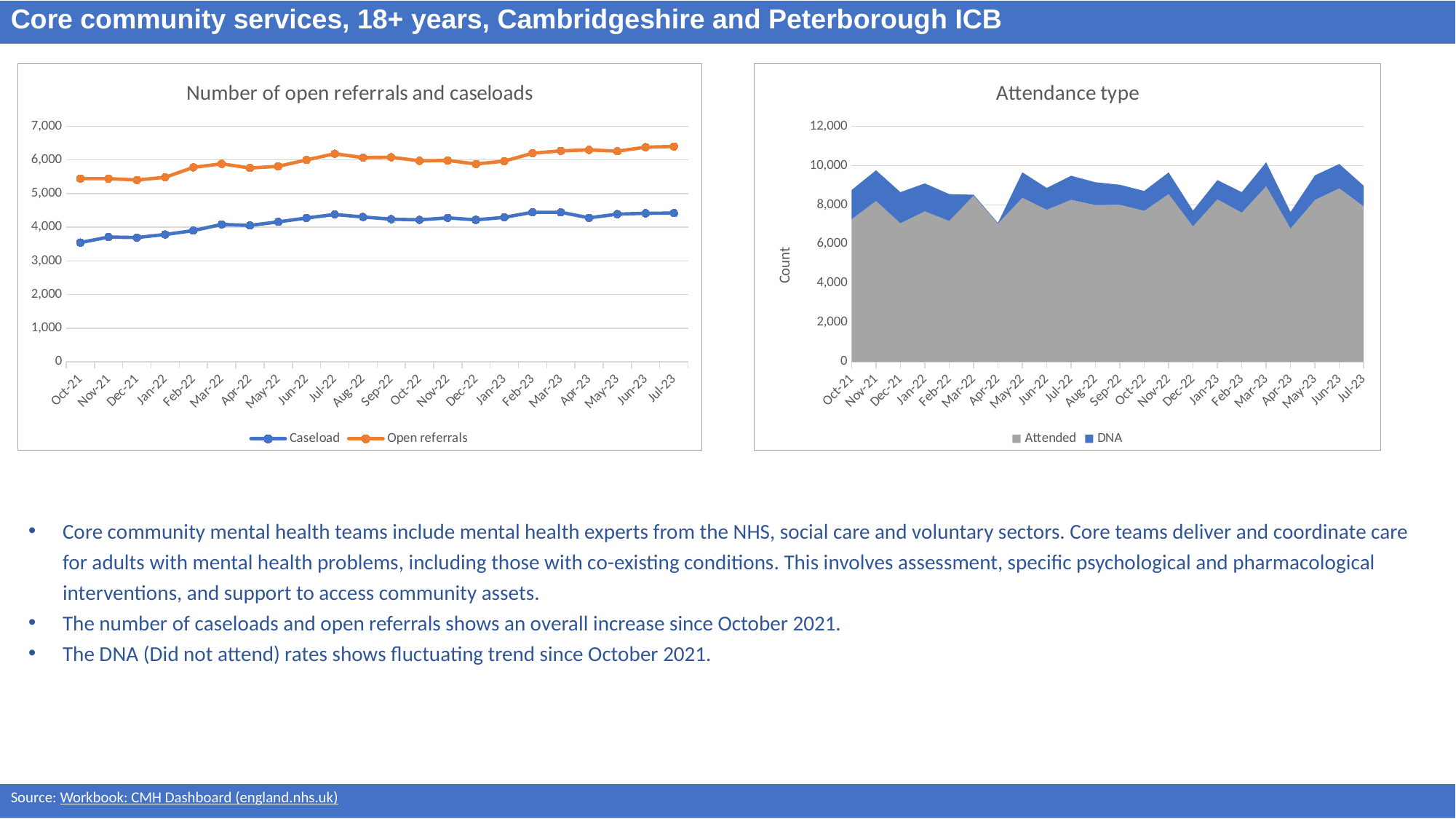
How many months are plotted on the x axis of the 'Number of open referrals and caseloads' chart? 22 In the 'Number of open referrals and caseloads' chart, does the Caseload series generally rise or fall from Oct-21 to Jul-23? Rise What type of chart is the 'Number of open referrals and caseloads' chart? Line chart In the 'Number of open referrals and caseloads' chart, which series is higher in Jul-23, Caseload or Open referrals? Open referrals What type of chart is the 'Attendance type' chart? Stacked area chart Which series are listed in the legend of the 'Attendance type' chart? Attended and DNA In the 'Attendance type' chart, is the Attended value for Oct-21 greater or less than 6,000? greater In the 'Number of open referrals and caseloads' chart, which month has the lowest Caseload value? Oct-21 In the 'Number of open referrals and caseloads' chart, is the Caseload value for Oct-21 greater or less than 4,000? less In the 'Number of open referrals and caseloads' chart, is the Open referrals value for Jul-23 greater or less than 6,000? greater In the 'Attendance type' chart, which series is larger in Oct-21, Attended or DNA? Attended How many series does the legend of the 'Number of open referrals and caseloads' chart list? 2